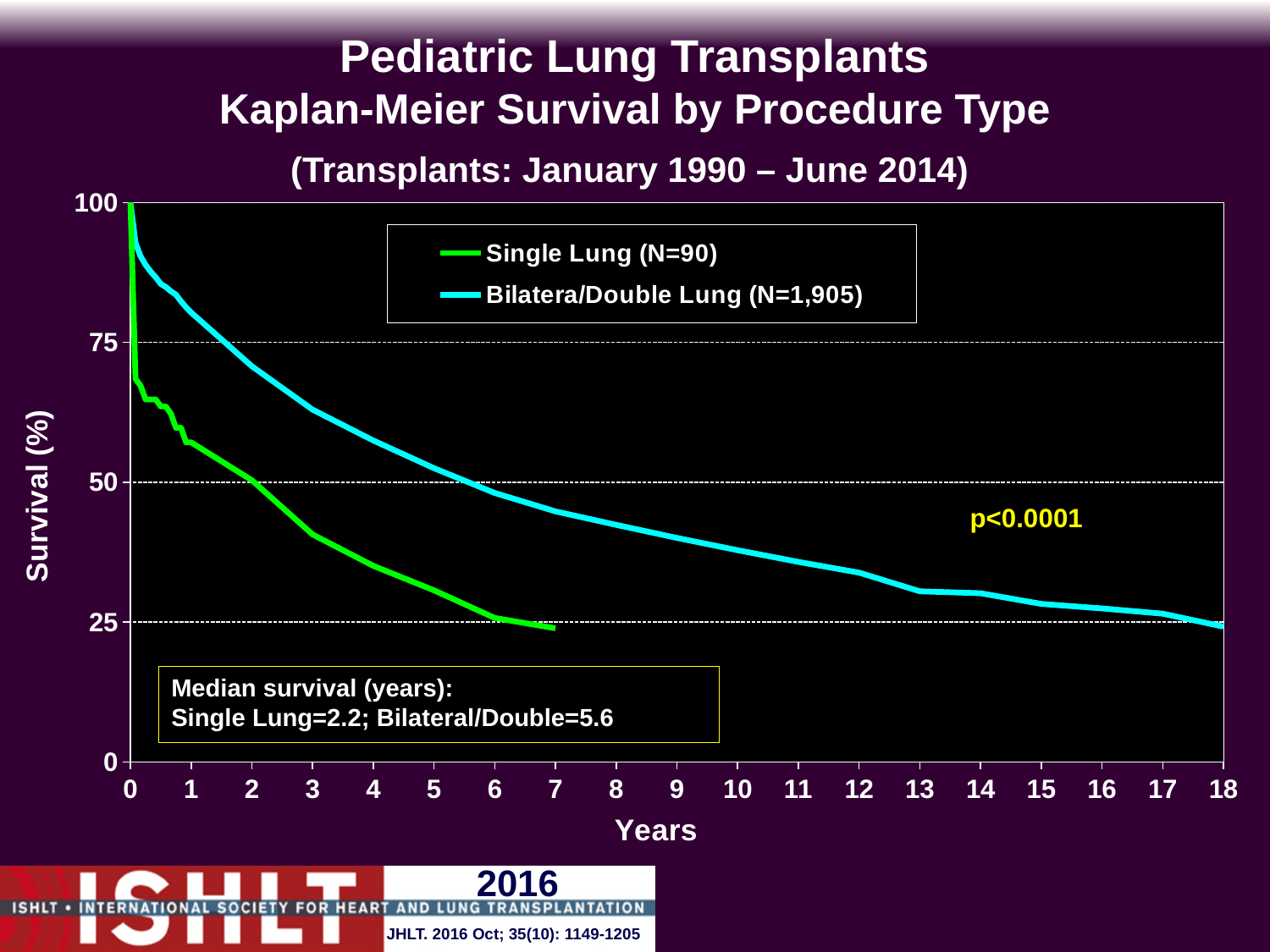
How many series does the legend list? 2 Do the survival curves rise or fall as years increase? fall Is the survival for Bilateral/Double Lung at 1 year greater or less than 75? greater At 5 years, which group has higher survival: Single Lung or Bilateral/Double Lung? Bilateral/Double Lung What is the median survival in years for Single Lung transplants? 2.2 What is the N for the Single Lung group shown in the legend? 90 Is the survival for Single Lung at 3 years greater or less than 50? less What p-value is shown on the chart? p<0.0001 What is the N for the Bilateral/Double Lung group shown in the legend? 1,905 Is the survival for Bilateral/Double Lung at 10 years greater or less than 50? less What is the median survival in years for Bilateral/Double lung transplants? 5.6 What kind of chart is shown on the slide? line chart